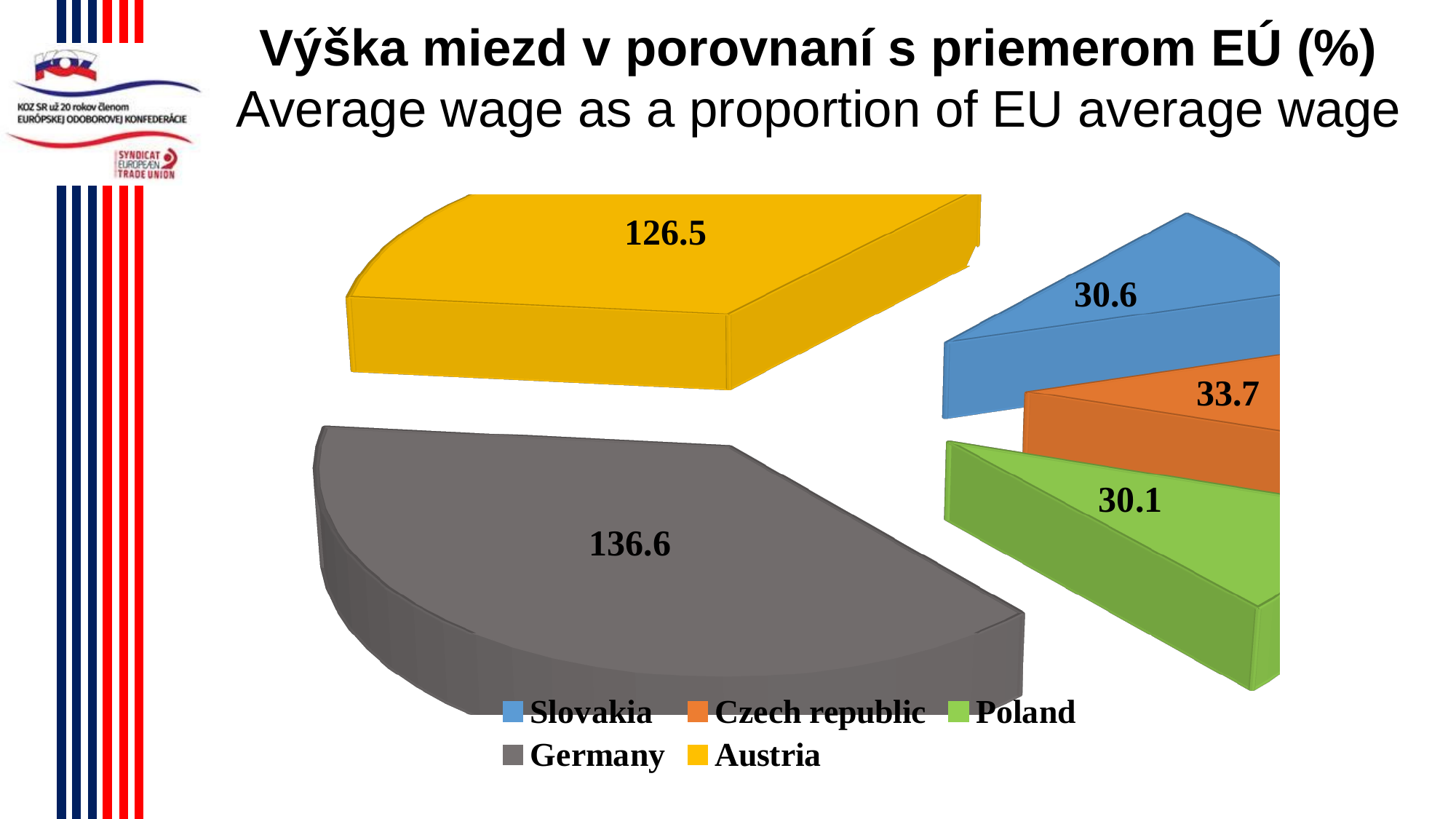
What is the value shown for the Czech republic? 33.7 What is the value shown for Poland? 30.1 How many countries are shown in the pie chart? 5 What is the value shown for Slovakia? 30.6 What is the difference between the values for Germany and Austria? 10.1 Which country has the lowest value in the pie chart? Poland Which country has the highest value in the pie chart? Germany What is the value shown for Austria? 126.5 Which has a larger value, Slovakia or Poland? Slovakia What is the difference between the values for the Czech republic and Slovakia? 3.1 What is the value shown for Germany? 136.6 What type of chart is shown on the slide? Pie chart